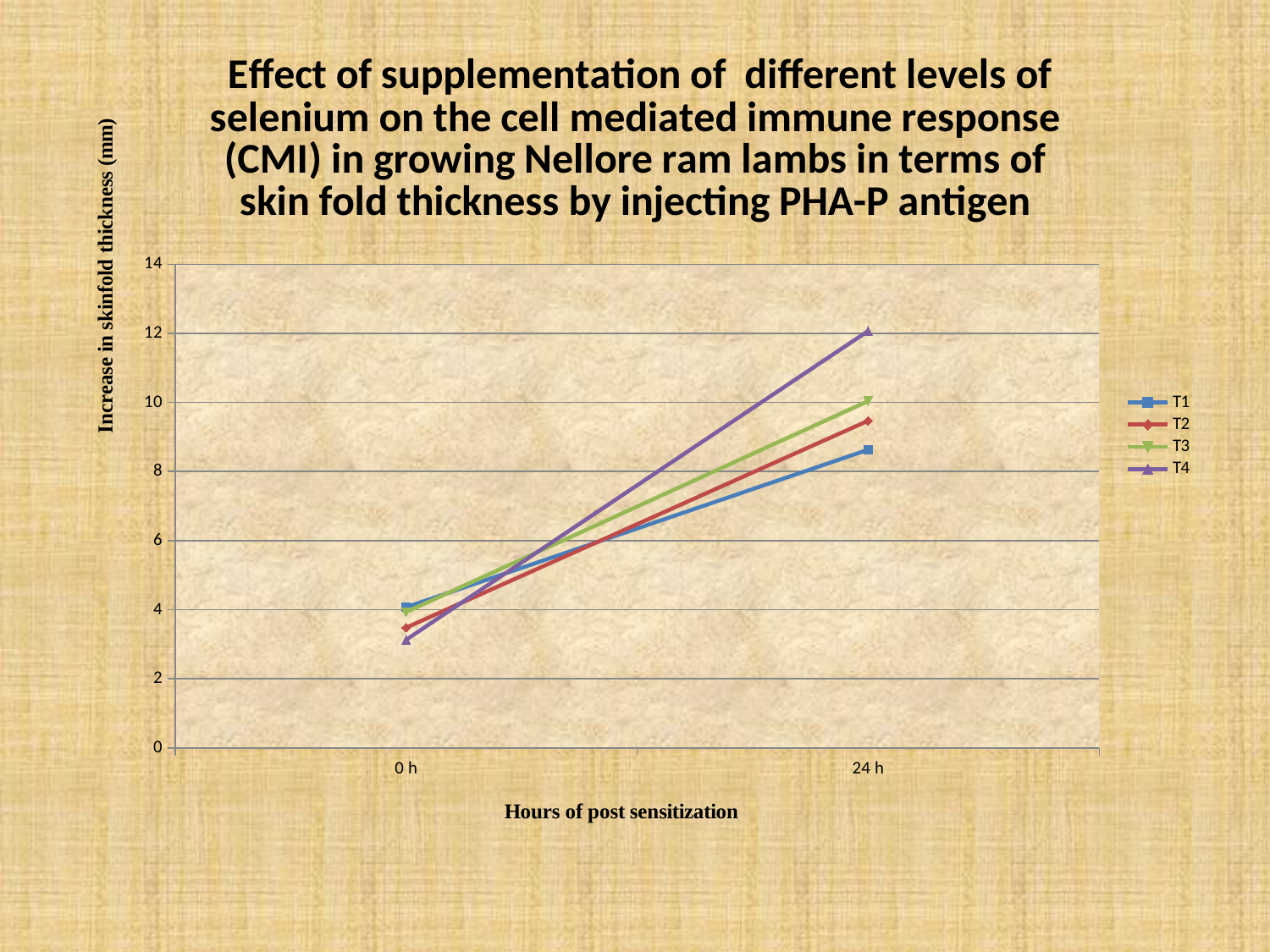
Which series has the highest value at 24 h? T4 What is the title of the x axis? Hours of post sensitization Is the value for T2 at 0 h greater or less than 4? less How many time points are plotted along the x axis? 2 Is the value for T1 at 24 h greater or less than 10? less Is the value for T4 at 24 h greater or less than 10? greater Which series has the lowest value at 0 h? T4 At 24 h, which is larger, the value for T4 or the value for T1? T4 Which series has the lowest value at 24 h? T1 What kind of chart is shown on the slide? line chart How many series does the legend list? 4 Do the values for T4 rise or fall from 0 h to 24 h? rise